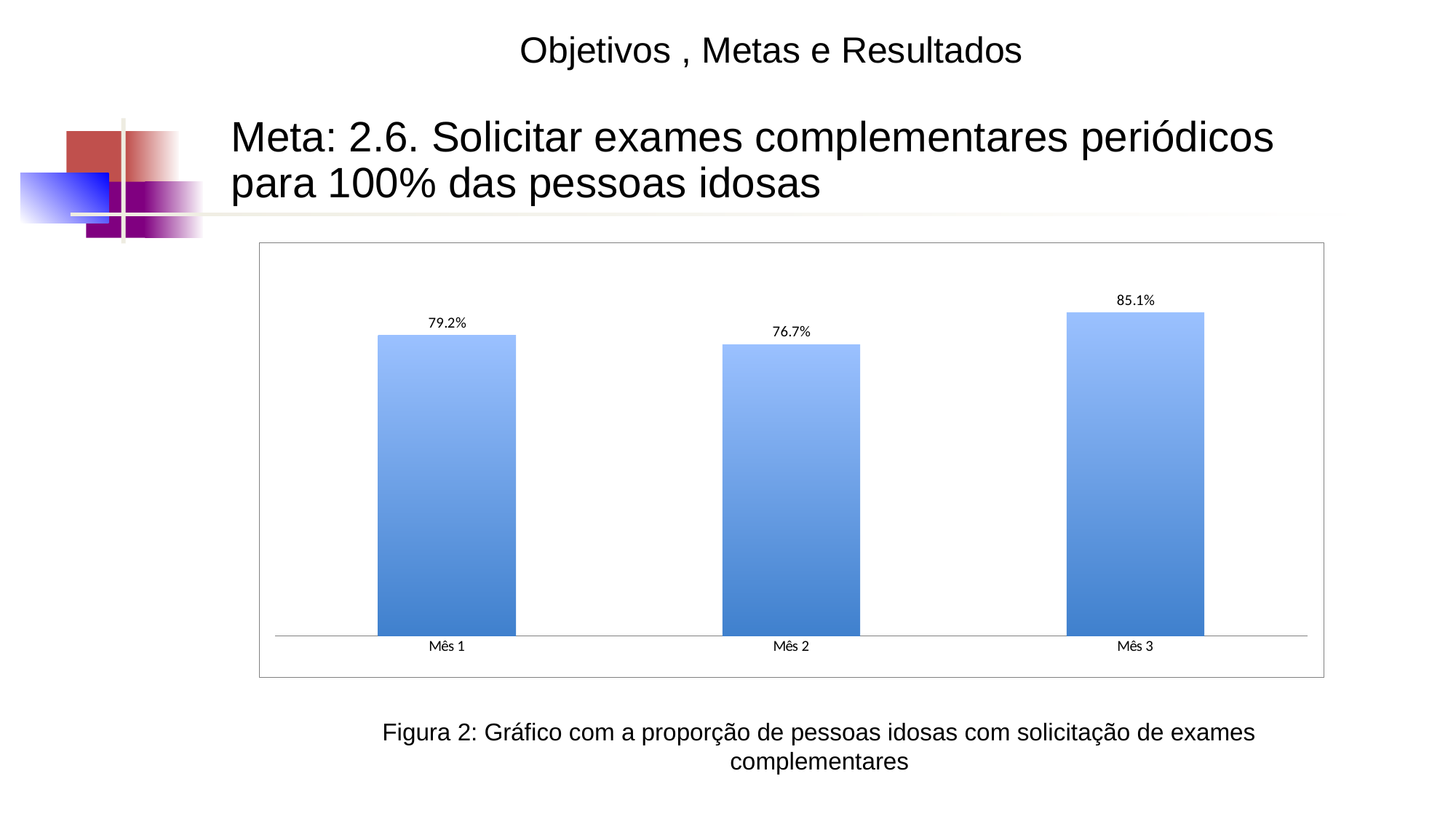
What is the figure caption below the chart? Figura 2: Gráfico com a proporção de pessoas idosas com solicitação de exames complementares What kind of chart is shown on the slide? Bar chart Which month has the lowest value? Mês 2 Does the value rise or fall from Mês 2 to Mês 3? Rise What is the value for Mês 1? 79.2% What is the value for Mês 3? 85.1% How many categories are shown in the chart? 3 What is the difference between the values for Mês 1 and Mês 2? 2.5% What is the value for Mês 2? 76.7% Which is larger, the value for Mês 1 or the value for Mês 2? Mês 1 Which month has the highest value? Mês 3 What is the difference between the values for Mês 3 and Mês 1? 5.9%